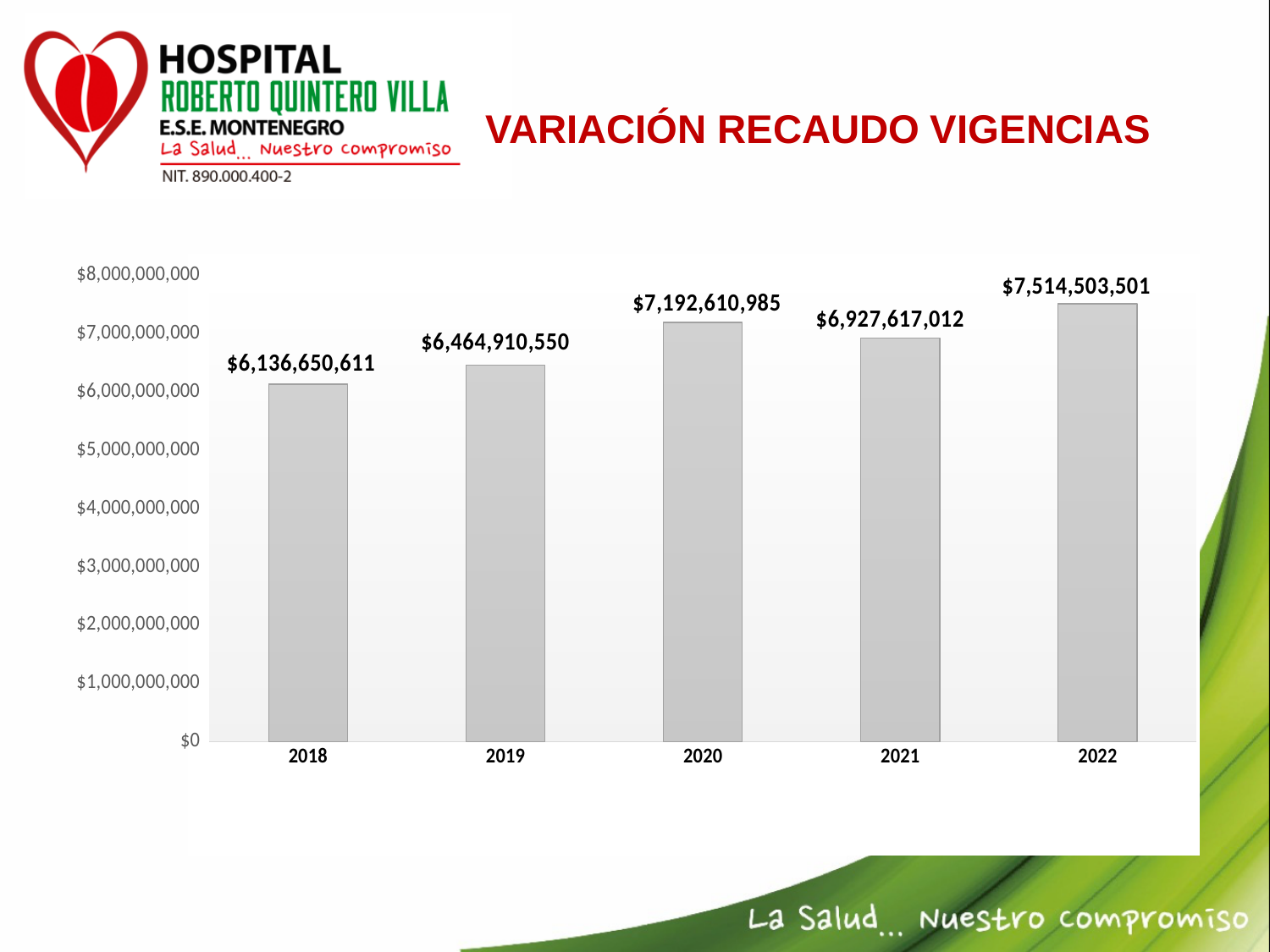
What is the difference between the values for 2022 and 2018? $1,377,852,890 Which year has the highest value? 2022 How many years are shown on the x axis? 5 Which is larger, the value for 2020 or the value for 2021? 2020 Does the value rise or fall from 2020 to 2021? fall What is the value for 2018? $6,136,650,611 Which year has the lowest value? 2018 Is the value for 2019 greater or less than $7,000,000,000? less What is the value for 2022? $7,514,503,501 What is the difference between the values for 2020 and 2021? $264,993,973 What kind of chart is shown on the slide? bar chart What is the value for 2020? $7,192,610,985